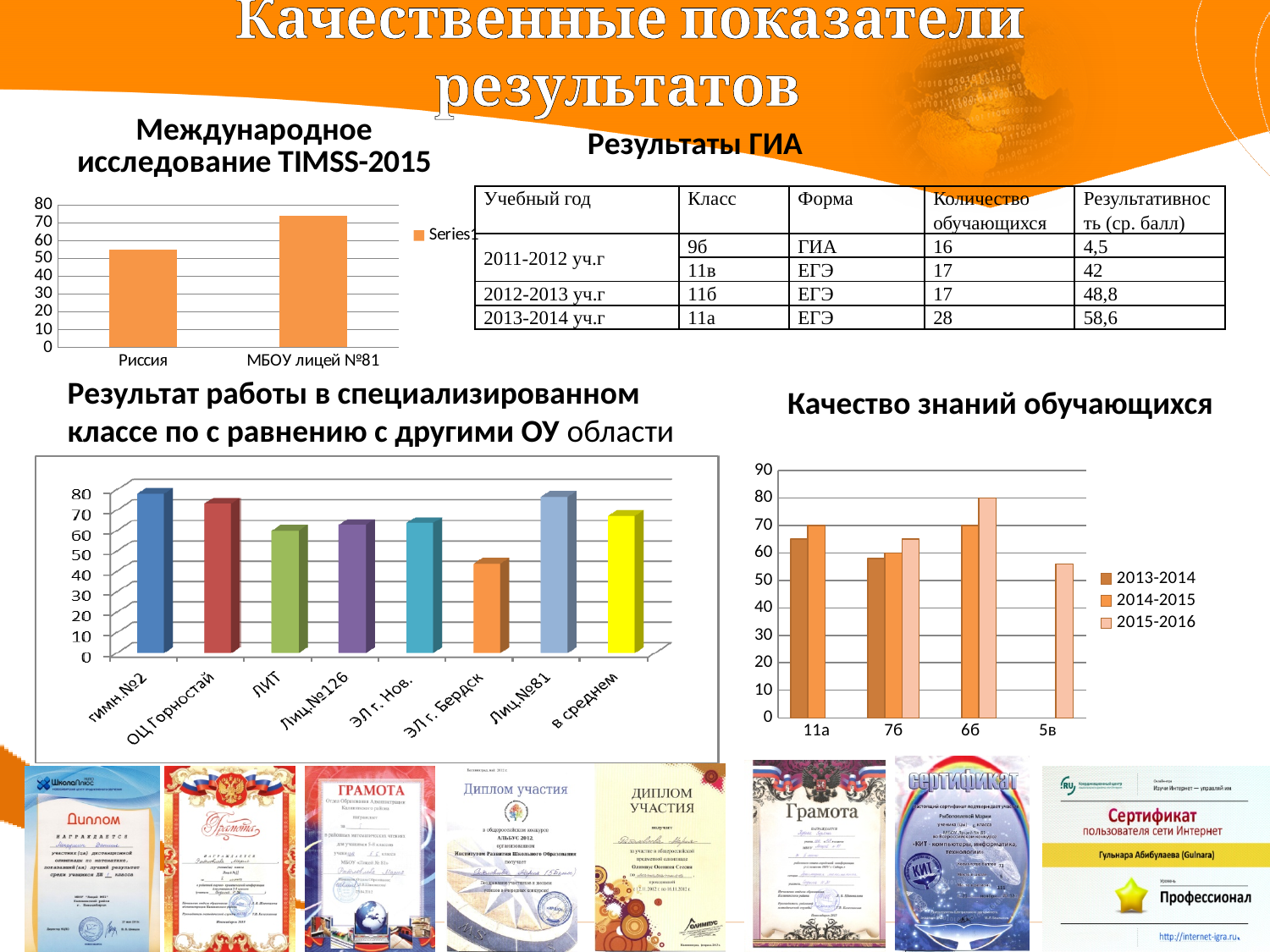
In the chart titled 'Международное исследование TIMSS-2015', which category has the higher value, Риссия or МБОУ лицей №81? МБОУ лицей №81 In the chart titled 'Международное исследование TIMSS-2015', is the value for МБОУ лицей №81 greater or less than 70? greater In the chart titled 'Качество знаний обучающихся', is the 2015-2016 value for 6б greater or less than 70? greater In the bottom-left chart (Результат работы в специализированном классе), which category has the lowest value? ЭЛ г. Бердск In the bottom-left chart (Результат работы в специализированном классе), how many categories are shown on the x axis? 8 In the chart titled 'Качество знаний обучающихся', which category has the highest bar? 6б In the chart titled 'Международное исследование TIMSS-2015', what kind of chart is shown? bar chart In the chart titled 'Международное исследование TIMSS-2015', is the value for Риссия greater or less than 60? less In the chart titled 'Качество знаний обучающихся', how many series does the legend list? 3 In the chart titled 'Международное исследование TIMSS-2015', what is the legend entry shown? Series1 In the chart titled 'Международное исследование TIMSS-2015', how many categories are shown on the x axis? 2